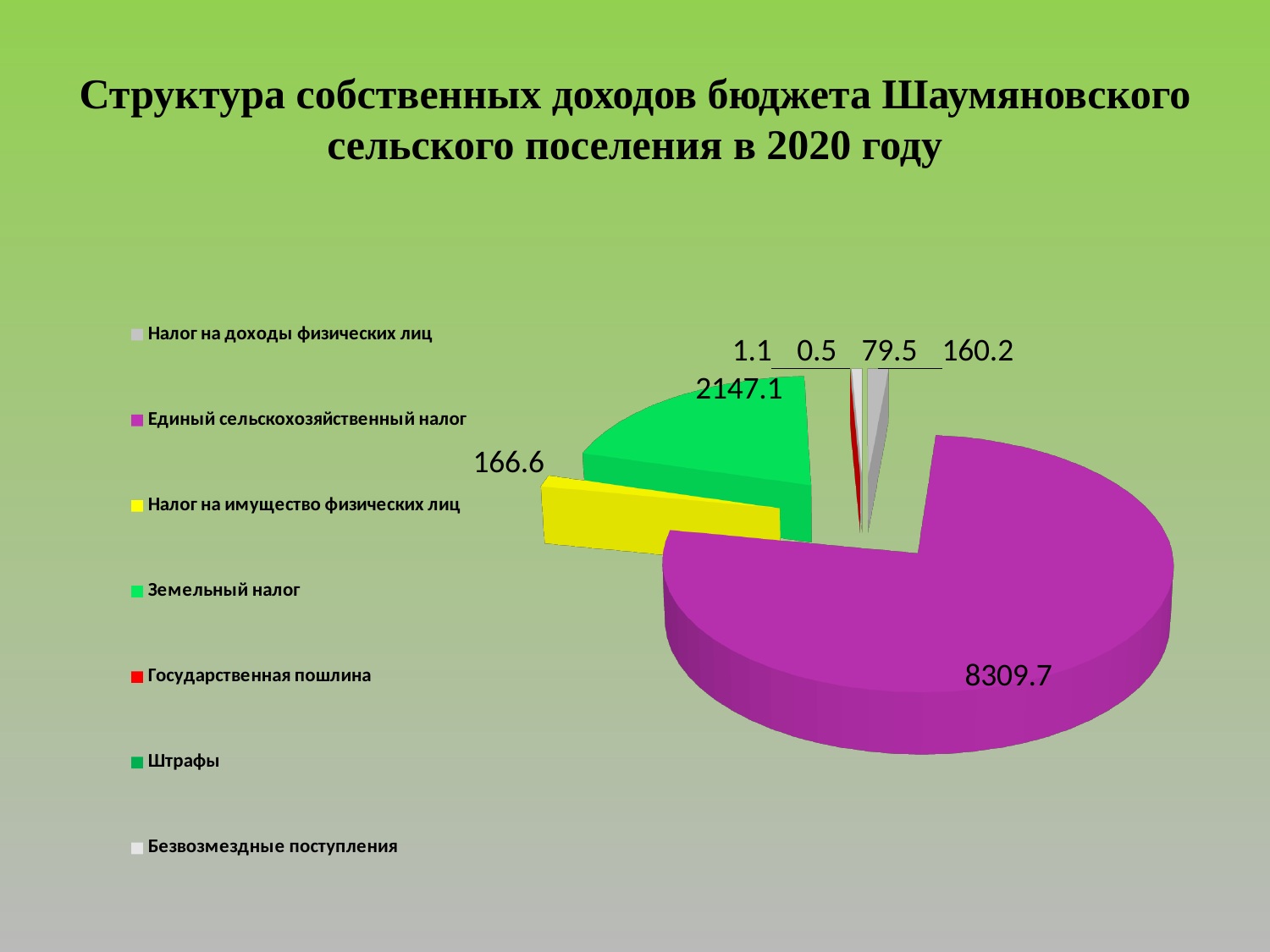
What is the value for Налог на имущество физических лиц? 166.6 Which category has the largest slice of the pie? Единый сельскохозяйственный налог What colour is the slice for Единый сельскохозяйственный налог? purple What kind of chart is shown on the slide? pie chart What is the value for Земельный налог? 2147.1 Which is larger: Земельный налог or Налог на имущество физических лиц? Земельный налог What is the difference between the values for Земельный налог and Налог на имущество физических лиц? 1980.5 What is the title of the slide? Структура собственных доходов бюджета Шаумяновского сельского поселения в 2020 году What is the value for Единый сельскохозяйственный налог? 8309.7 What is the smallest value printed on the chart? 0.5 What is the difference between the values for Единый сельскохозяйственный налог and Земельный налог? 6162.6 How many categories does the legend list? 7